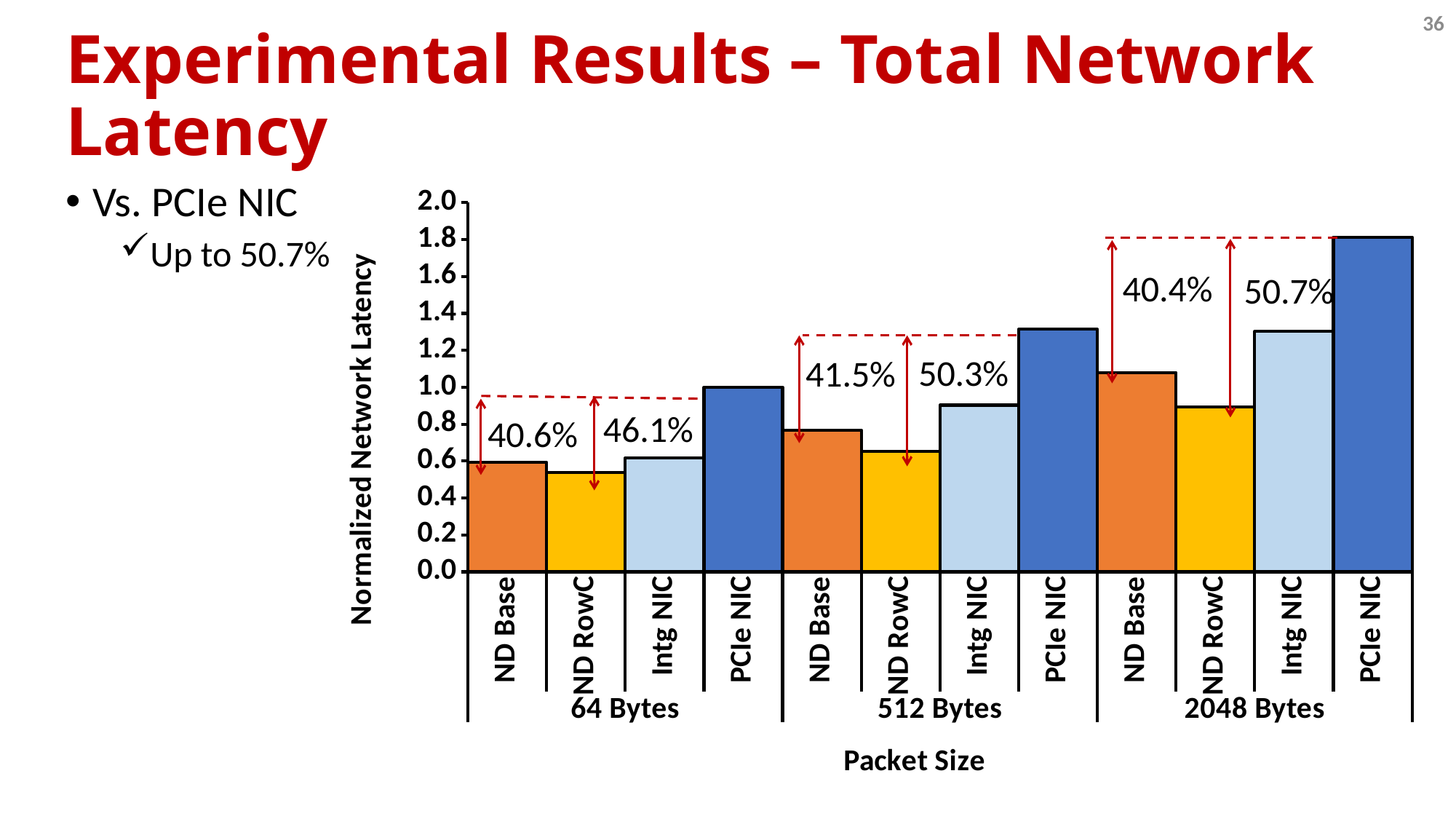
What percentage is annotated above the ND Base bar for 512 Bytes? 41.5% Which bar has the highest normalized network latency in the chart? PCIe NIC at 2048 Bytes How many bars are plotted in total across all packet sizes? 12 How many packet size groups are shown on the x axis? 3 Is the normalized network latency for PCIe NIC at 2048 Bytes greater or less than 1.6? greater What kind of chart is shown on the slide? bar chart Is the normalized network latency for ND RowC at 64 Bytes greater or less than 0.6? less What percentage is annotated above the ND RowC bar for 2048 Bytes? 50.7% Does the normalized network latency of PCIe NIC rise or fall as packet size increases from 64 Bytes to 2048 Bytes? rise Which bar has the lowest normalized network latency in the chart? ND RowC at 64 Bytes What is the normalized network latency of PCIe NIC at 64 Bytes? 1.0 What is the title of the y axis of the chart? Normalized Network Latency